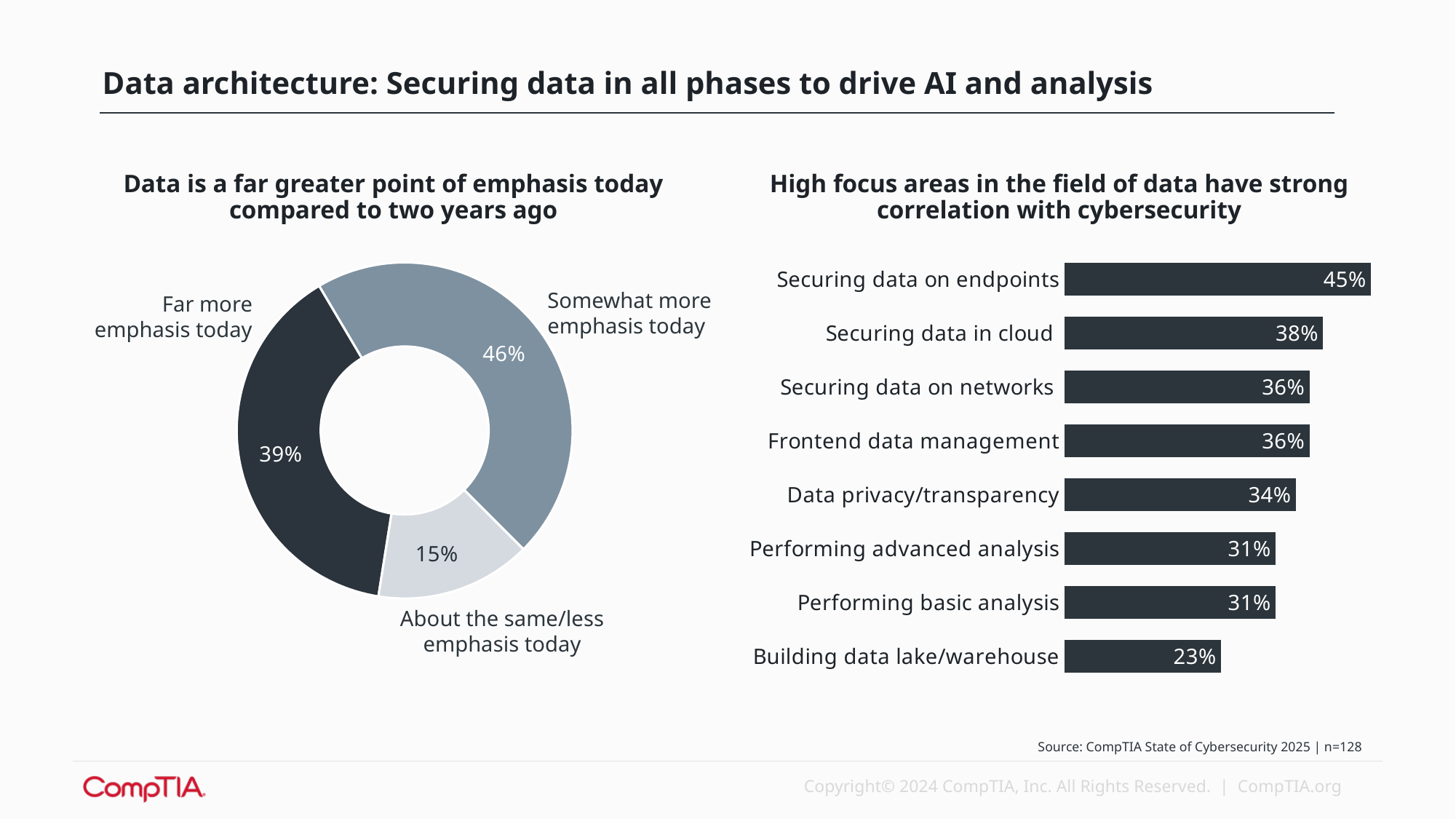
In the left chart (Data is a far greater point of emphasis today compared to two years ago), what percentage is shown for 'About the same/less emphasis today'? 15% In the left chart (Data is a far greater point of emphasis today compared to two years ago), which category has the largest share? Somewhat more emphasis today In the left chart (Data is a far greater point of emphasis today compared to two years ago), how many categories are shown? 3 In the right chart (High focus areas in the field of data have strong correlation with cybersecurity), what is the value for 'Securing data in cloud'? 38% In the right chart (High focus areas in the field of data have strong correlation with cybersecurity), what is the difference between 'Securing data on endpoints' and 'Building data lake/warehouse'? 22% In the right chart (High focus areas in the field of data have strong correlation with cybersecurity), what kind of chart is shown? Bar chart In the right chart (High focus areas in the field of data have strong correlation with cybersecurity), which category has the lowest value? Building data lake/warehouse In the right chart (High focus areas in the field of data have strong correlation with cybersecurity), how many categories are shown? 8 In the left chart (Data is a far greater point of emphasis today compared to two years ago), what kind of chart is shown? Doughnut chart In the right chart (High focus areas in the field of data have strong correlation with cybersecurity), which category has the highest value? Securing data on endpoints In the right chart (High focus areas in the field of data have strong correlation with cybersecurity), what is the value for 'Data privacy/transparency'? 34% In the left chart (Data is a far greater point of emphasis today compared to two years ago), what percentage is shown for 'Far more emphasis today'? 39%